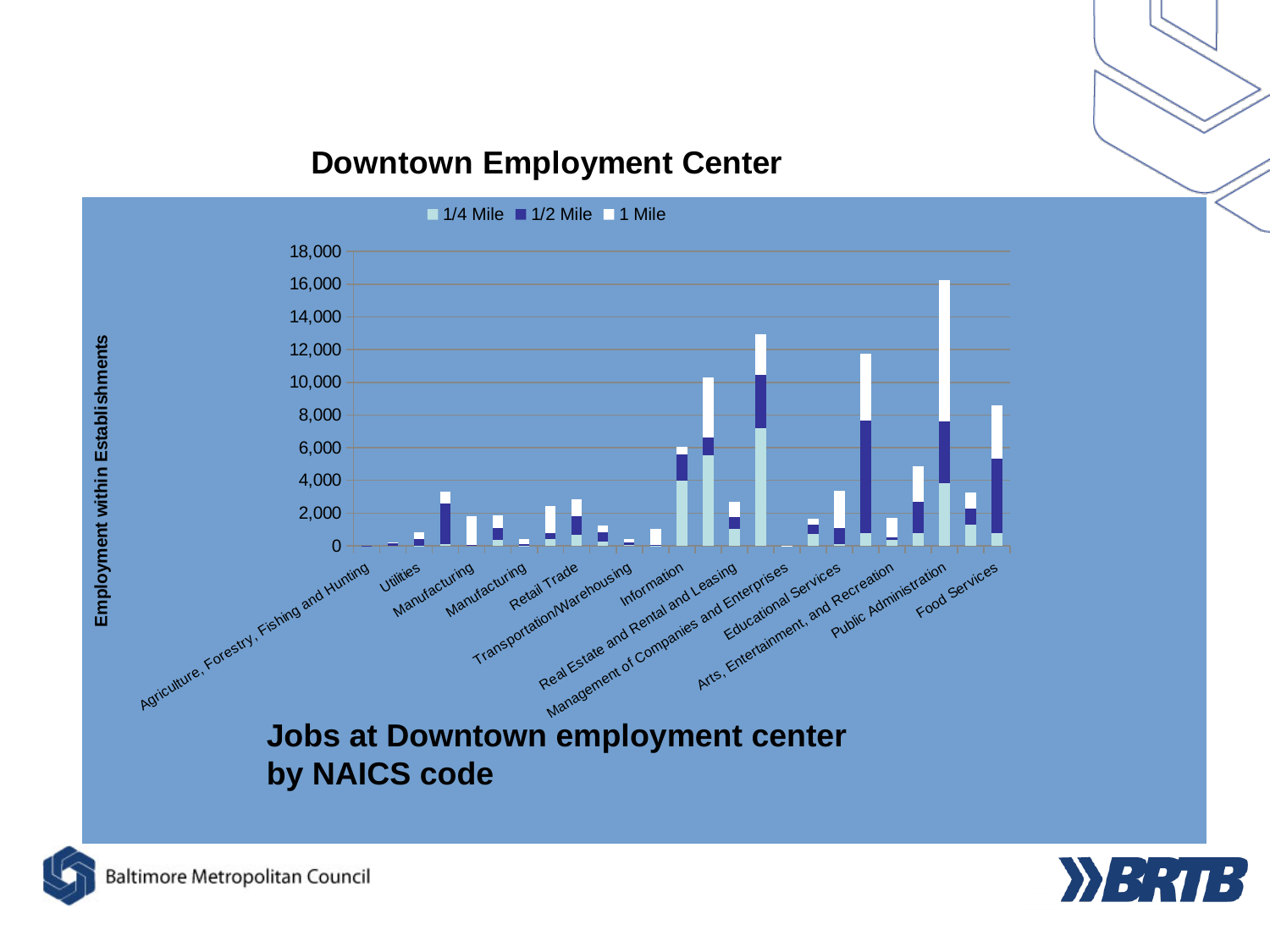
What is the highest value shown on the y-axis? 18,000 Is the stacked bar for Utilities greater or less than 2,000? less What is the title of the y-axis? Employment within Establishments Is the tallest stacked bar greater or less than 18,000? less What are the three series named in the legend? 1/4 Mile, 1/2 Mile, 1 Mile What kind of chart is shown on the slide? Stacked bar chart How many series does the legend list? 3 Is the tallest stacked bar greater or less than 14,000? greater